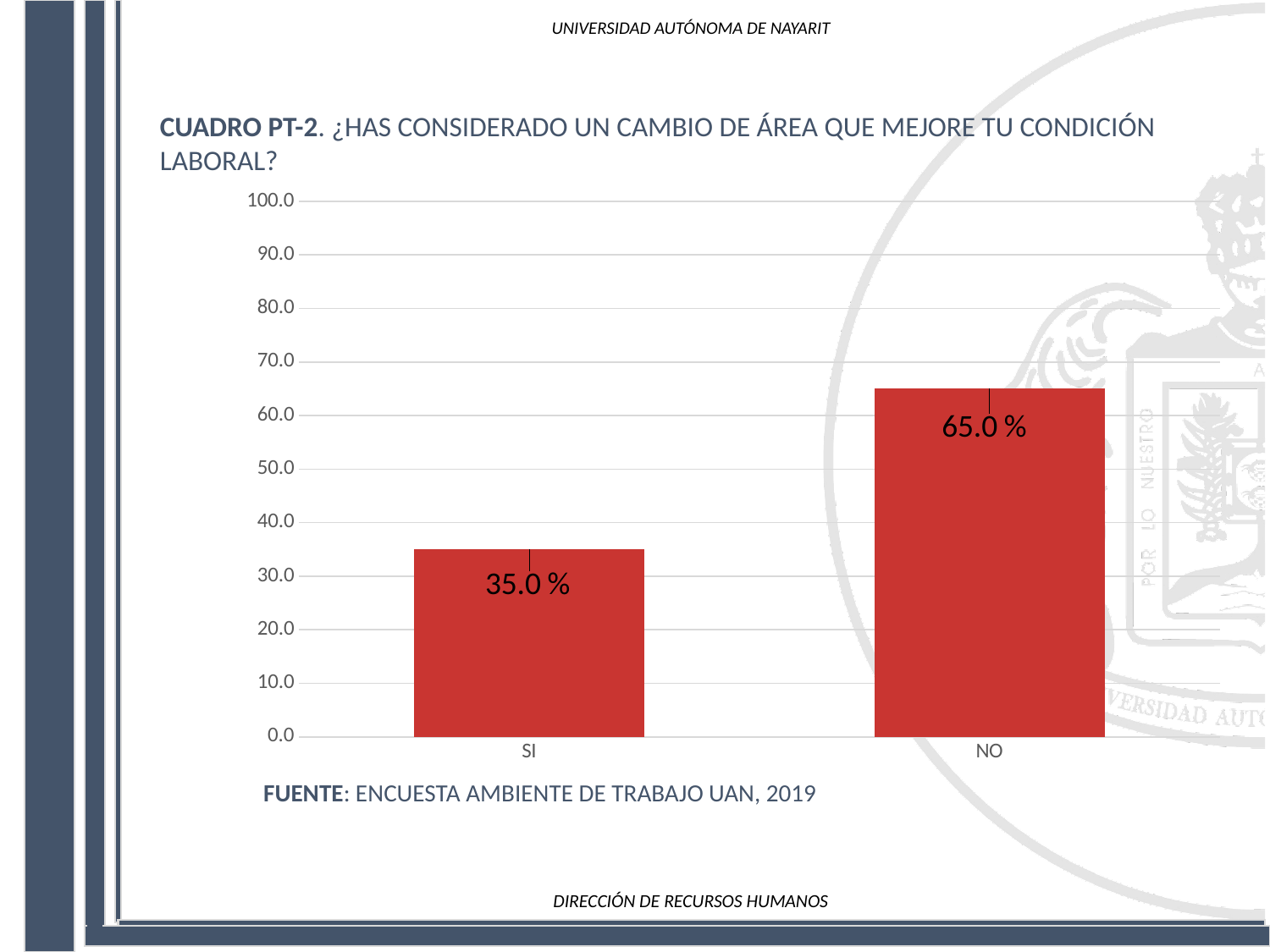
What is the maximum value shown on the y axis? 100.0 What kind of chart is shown on the slide? bar chart Which category has the highest value? NO Is the value for NO greater or less than 60.0? greater Which category has the lowest value? SI What is the difference between the values for NO and SI? 30.0 % What is the value for NO? 65.0 % What source is cited below the chart? ENCUESTA AMBIENTE DE TRABAJO UAN, 2019 Is the value for SI greater or less than 40.0? less What is the value for SI? 35.0 % How many categories are shown on the x axis? 2 Which is larger, the value for SI or the value for NO? NO